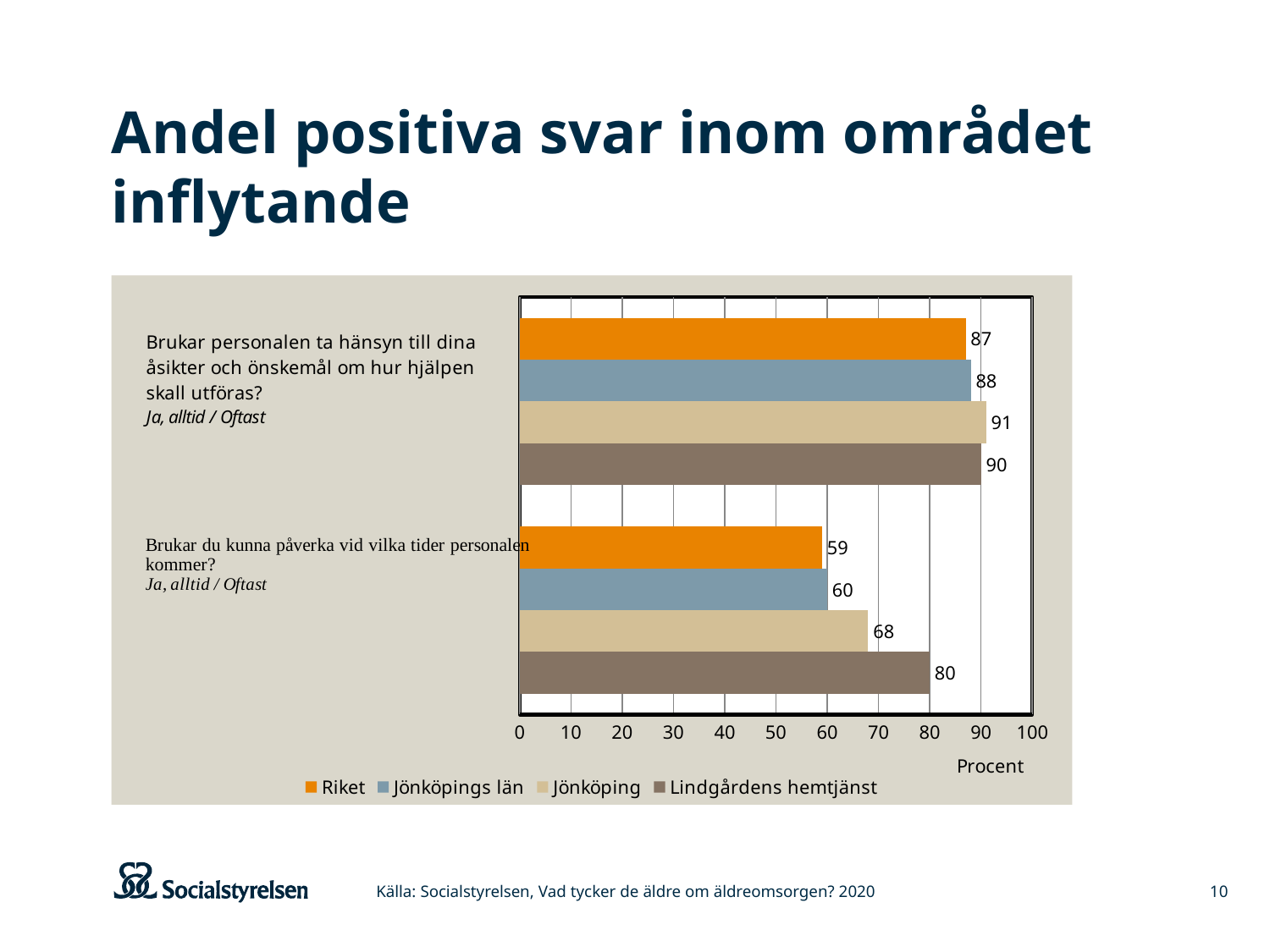
How many question categories are shown on the chart? 2 What is the value for Lindgårdens hemtjänst on the question "Brukar du kunna påverka vid vilka tider personalen kommer?"? 80 What is the value for Jönköpings län on the question "Brukar personalen ta hänsyn till dina åsikter och önskemål om hur hjälpen skall utföras?"? 88 What is the label of the horizontal axis? Procent Which is larger on the question "Brukar du kunna påverka vid vilka tider personalen kommer?": Jönköping or Jönköpings län? Jönköping Which series has the lowest value on the question "Brukar du kunna påverka vid vilka tider personalen kommer?"? Riket How many series does the legend list? 4 What kind of chart is shown on the slide? Bar chart What is the value for Jönköping on the question "Brukar du kunna påverka vid vilka tider personalen kommer?"? 68 What is the value for Riket on the question "Brukar personalen ta hänsyn till dina åsikter och önskemål om hur hjälpen skall utföras?"? 87 Which series has the highest value on the question "Brukar personalen ta hänsyn till dina åsikter och önskemål om hur hjälpen skall utföras?"? Jönköping What is the difference between Lindgårdens hemtjänst and Riket on the question "Brukar du kunna påverka vid vilka tider personalen kommer?"? 21